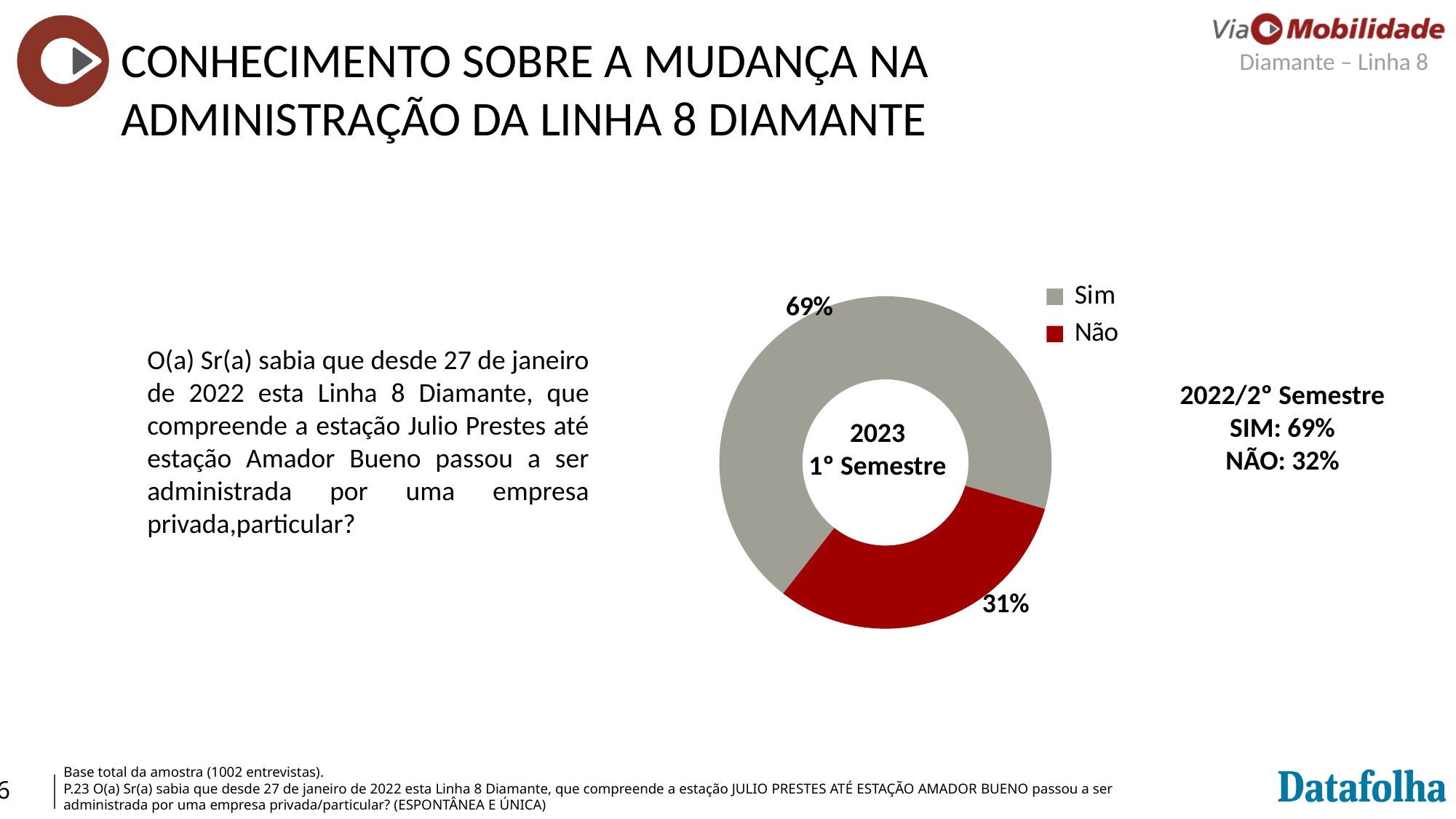
What is the difference in percentage points between the "Sim" and "Não" slices? 38 percentage points What percentage of respondents answered "Não" in the 2023 1° Semestre chart? 31% According to the text beside the chart, what was the "NÃO" percentage in 2022/2° Semestre? 32% What label appears in the centre of the doughnut chart? 2023 1° Semestre Which response has the smallest share in the chart? Não How many slices does the doughnut chart have? 2 What percentage of respondents answered "Sim" in the 2023 1° Semestre chart? 69% How many categories does the legend list? 2 Which slice is larger, "Sim" or "Não"? Sim What kind of chart is shown on the slide? Doughnut (pie) chart What colour represents "Não" in the chart? Dark red Which response has the largest share in the chart? Sim